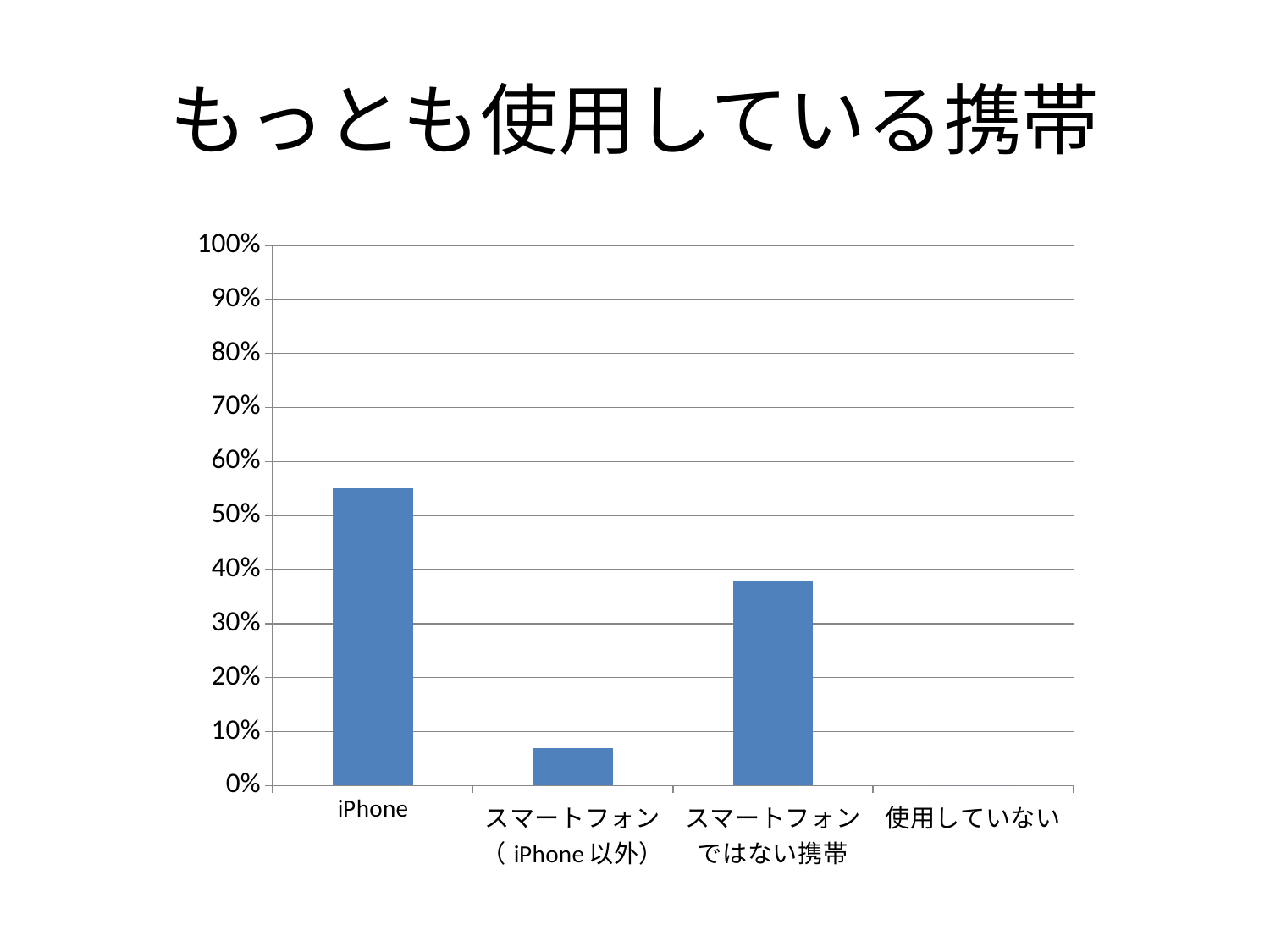
Which category has the highest value in the chart? iPhone What is the title of the chart? もっとも使用している携帯 Which category has the lowest value in the chart? 使用していない Which is larger, the value for スマートフォン（iPhone以外） or the value for スマートフォンではない携帯? スマートフォンではない携帯 How many categories are shown on the x axis of the chart? 4 Which is larger, the value for iPhone or the value for スマートフォンではない携帯? iPhone What kind of chart is shown on the slide? bar chart Is the value for iPhone greater or less than 50%? greater Is the value for スマートフォンではない携帯 greater or less than 30%? greater Is the value for iPhone greater or less than 60%? less